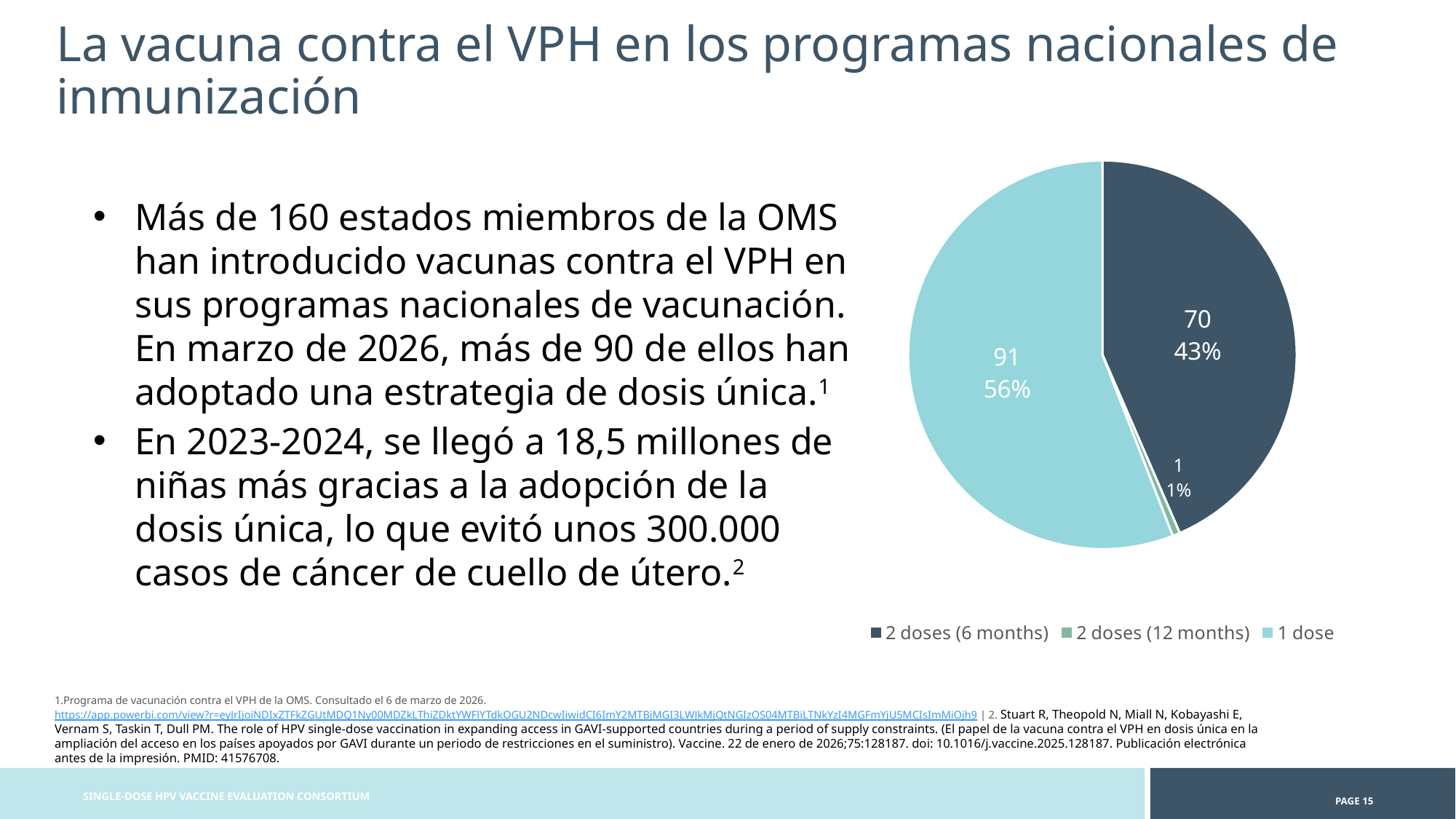
What is the value for the '2 doses (6 months)' slice? 70 What share of the pie does the '1 dose' slice represent? 56% What is the total of all three slices? 162 Which slice is the largest? 1 dose What share of the pie does the '2 doses (6 months)' slice represent? 43% What is the value for the '1 dose' slice? 91 What kind of chart is shown on the slide? pie chart What is the difference between the '1 dose' value and the '2 doses (6 months)' value? 21 What is the value for the '2 doses (12 months)' slice? 1 Which slice is the smallest? 2 doses (12 months) How many series does the legend list? 3 Which is larger, the '1 dose' slice or the '2 doses (6 months)' slice? 1 dose